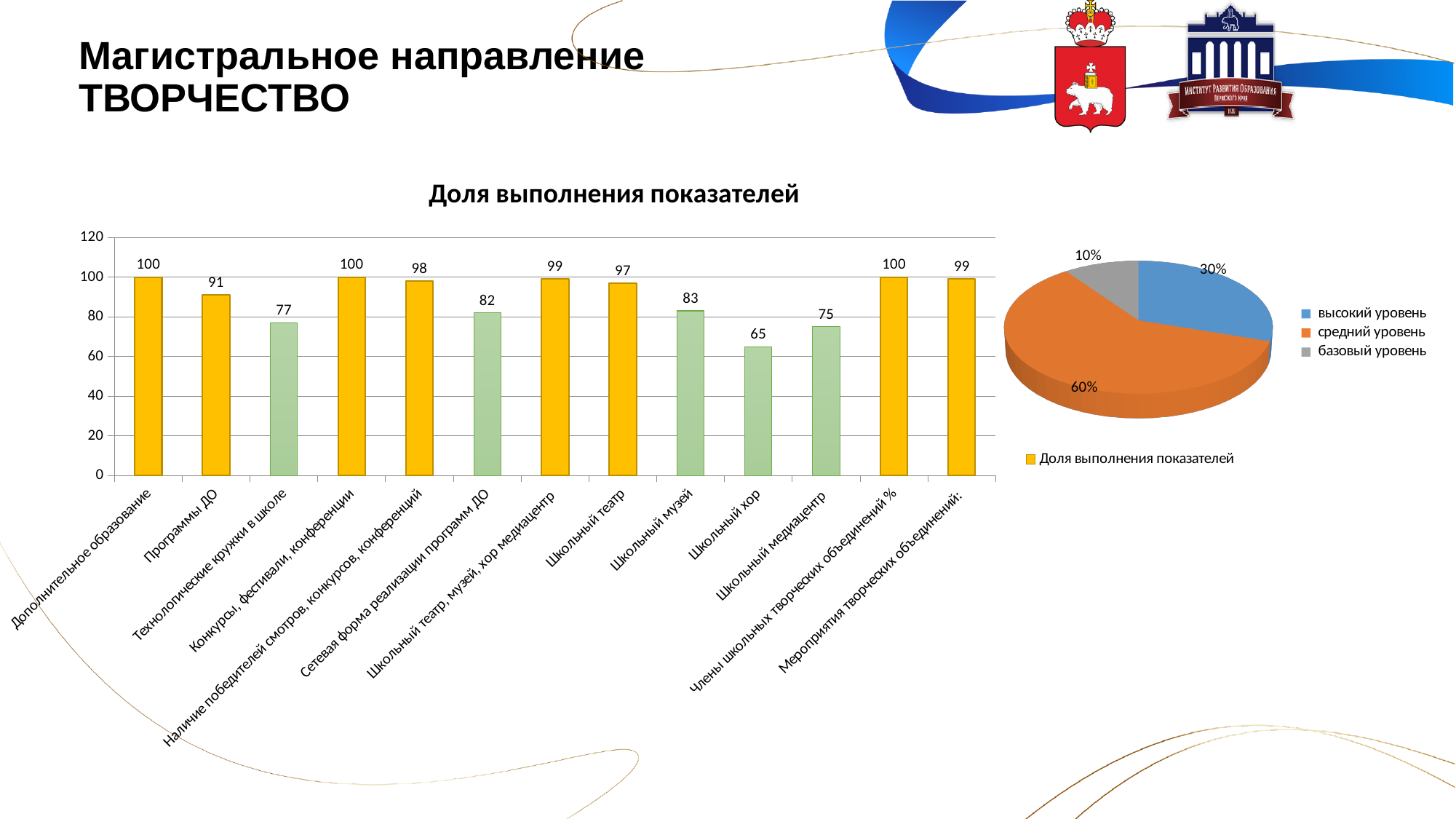
What kind of chart is the chart on the left titled 'Доля выполнения показателей'? bar chart In the bar chart 'Доля выполнения показателей', what is the difference between the values for Программы ДО and Школьный медиацентр? 16 How many entries does the legend of the pie chart on the right list? 3 In the bar chart 'Доля выполнения показателей', which category has the lowest value? Школьный хор In the pie chart on the right, what share does средний уровень have? 60% In the bar chart 'Доля выполнения показателей', how many categories are shown? 13 In the bar chart 'Доля выполнения показателей', what is the value for Технологические кружки в школе? 77 In the bar chart 'Доля выполнения показателей', what is the value for Сетевая форма реализации программ ДО? 82 In the pie chart on the right, which level has the largest slice? средний уровень In the bar chart 'Доля выполнения показателей', what is the value for Школьный хор? 65 In the bar chart 'Доля выполнения показателей', which is larger: the value for Школьный музей or the value for Школьный театр? Школьный театр In the pie chart on the right, what share does базовый уровень have? 10%